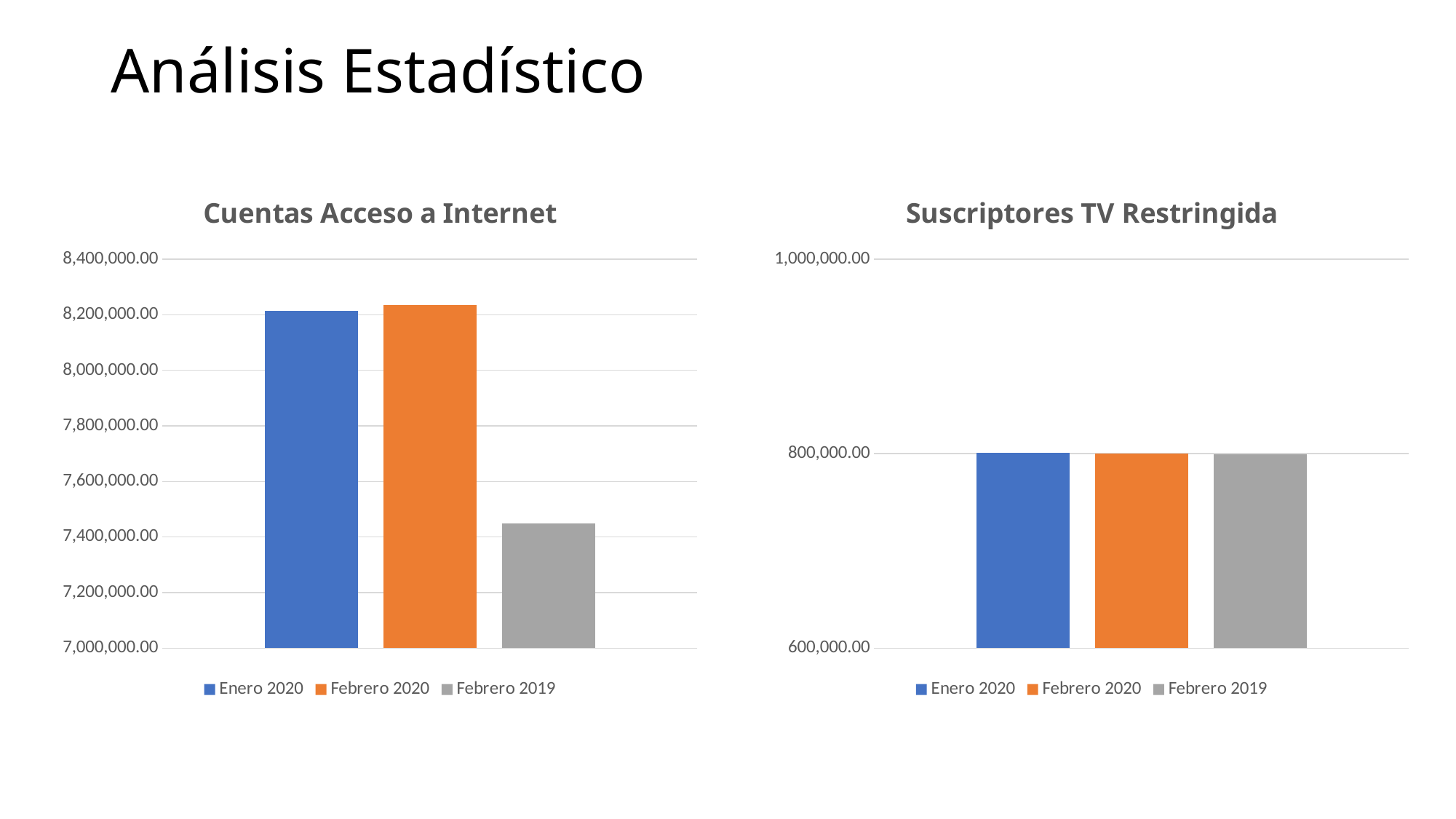
In the "Cuentas Acceso a Internet" chart, is the value for Enero 2020 greater or less than 8,000,000.00? greater How many bars are plotted in the "Suscriptores TV Restringida" chart? 3 In the "Cuentas Acceso a Internet" chart, which series has the lowest value? Febrero 2019 In the "Cuentas Acceso a Internet" chart, which is larger: Febrero 2020 or Febrero 2019? Febrero 2020 In the "Cuentas Acceso a Internet" chart, which series is shown in orange? Febrero 2020 What kind of chart is the "Suscriptores TV Restringida" chart? bar chart In the "Suscriptores TV Restringida" chart, is the value for Enero 2020 greater or less than 1,000,000.00? less How many series does the legend of the "Cuentas Acceso a Internet" chart list? 3 What is the title of the chart on the right side of the slide? Suscriptores TV Restringida In the "Cuentas Acceso a Internet" chart, is the value for Febrero 2019 greater or less than 7,600,000.00? less What kind of chart is the "Cuentas Acceso a Internet" chart? bar chart